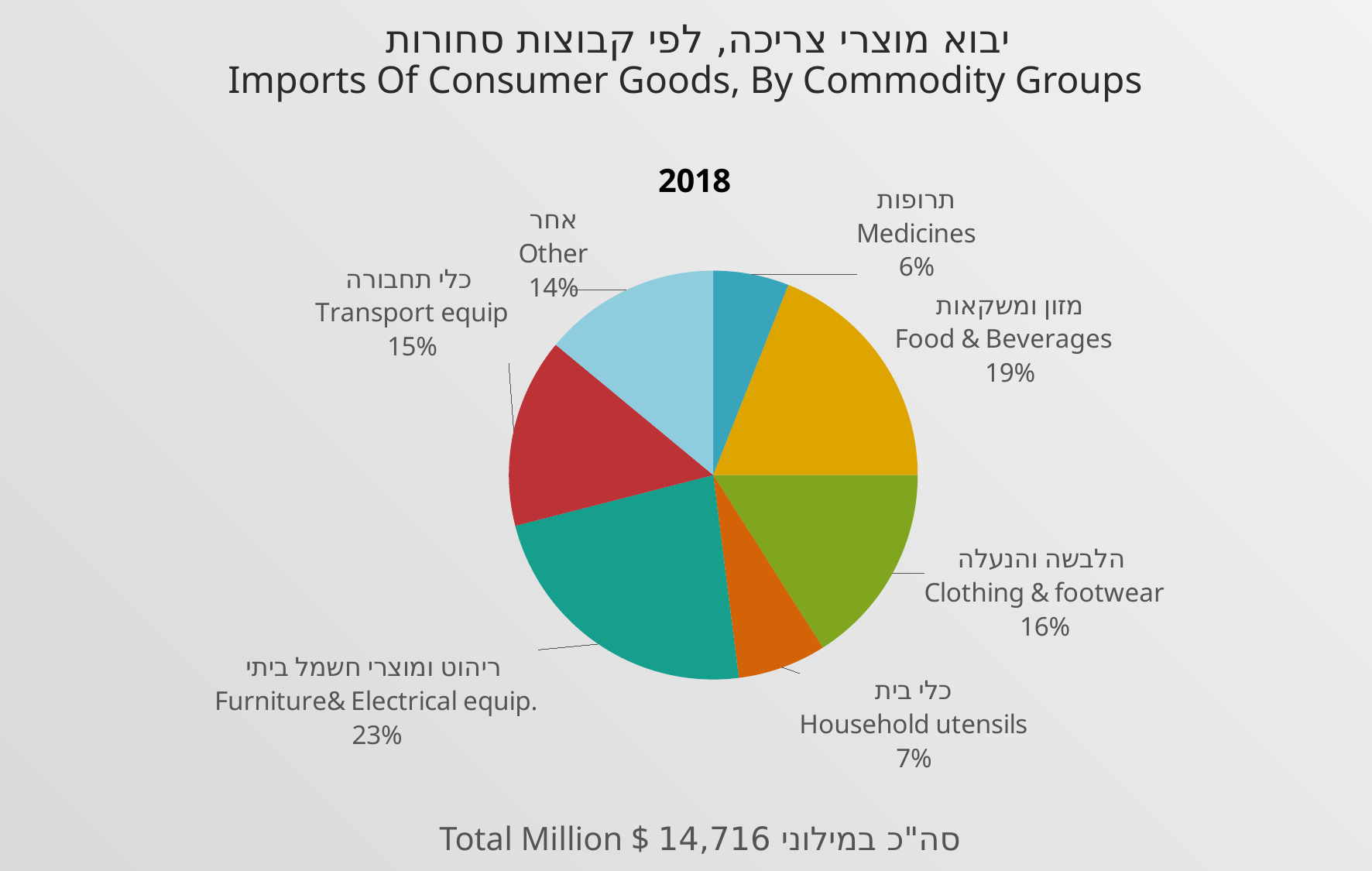
What year does the pie chart represent? 2018 Which commodity group has the largest share of consumer goods imports in 2018? Furniture& Electrical equip. What type of chart is shown on the slide? Pie chart What percentage of the pie is Medicines? 6% How many commodity groups are shown in the pie chart? 7 What is the total value of imports of consumer goods stated on the slide? Million $ 14,716 What is the difference in percentage points between Food & Beverages and Clothing & footwear? 3 What share of the pie is Household utensils? 7% What share does Furniture & Electrical equip. hold in the 2018 pie chart? 23% What share of imports of consumer goods in 2018 is Food & Beverages? 19% Which has a larger share: Transport equip or Other? Transport equip Which commodity group has the smallest share in the pie chart? Medicines